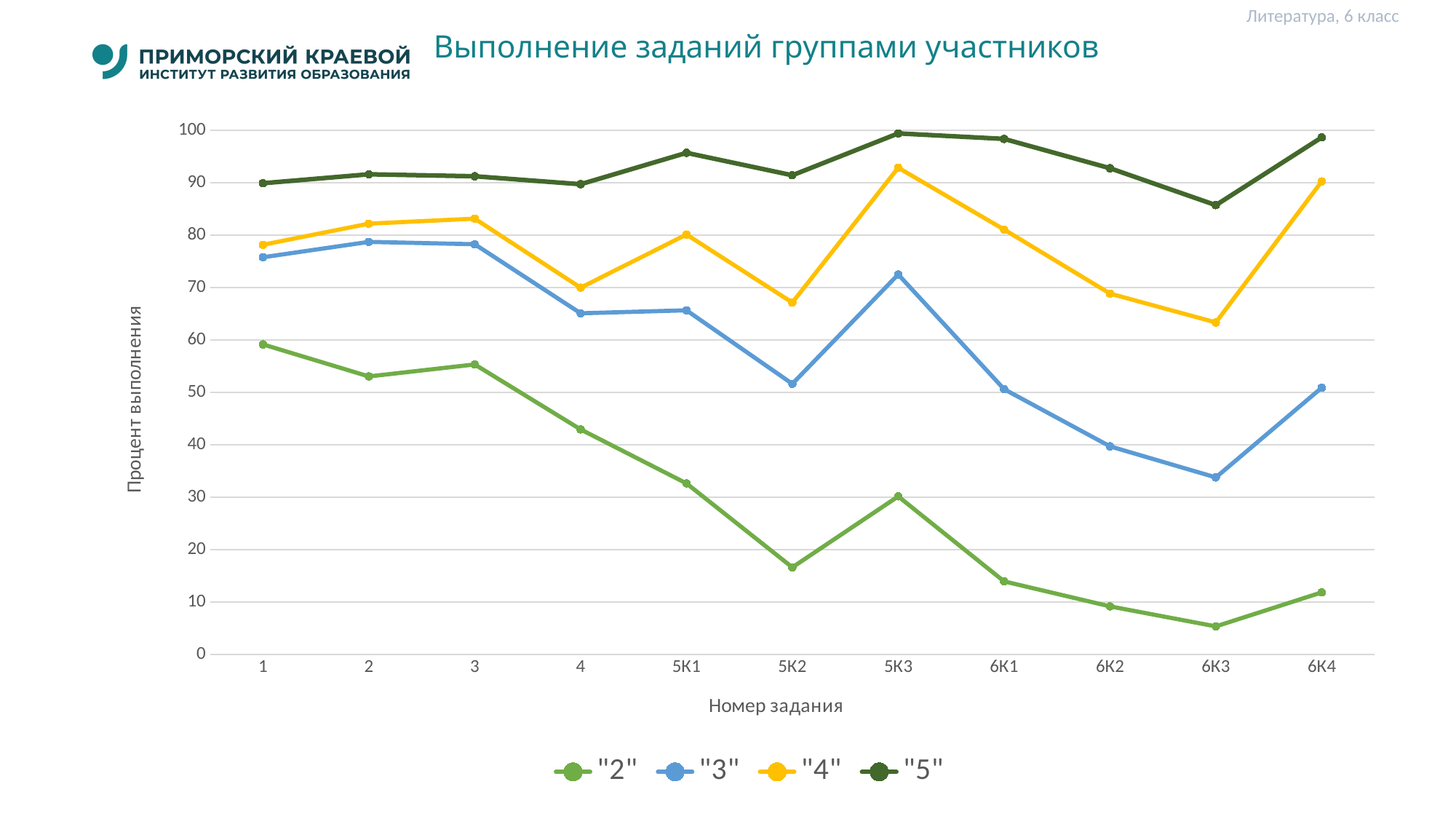
For which task is the value of series "5" lowest? 6К3 How many task categories are shown on the x axis? 11 How many series does the legend list? 4 Is the value for series "5" at task 5К1 greater or less than 90? greater Which is larger for series "3": the value at task 5К3 or the value at task 6К1? 5К3 Does the value of series "2" rise or fall from task 5К3 to task 6К3? fall For which task is the value of series "2" lowest? 6К3 What is the title of the x axis? Номер задания Is the value for series "3" at task 6К3 greater or less than 40? less What kind of chart is shown on the slide? line chart For which task is the value of series "4" highest? 5К3 For which task is the value of series "2" highest? 1